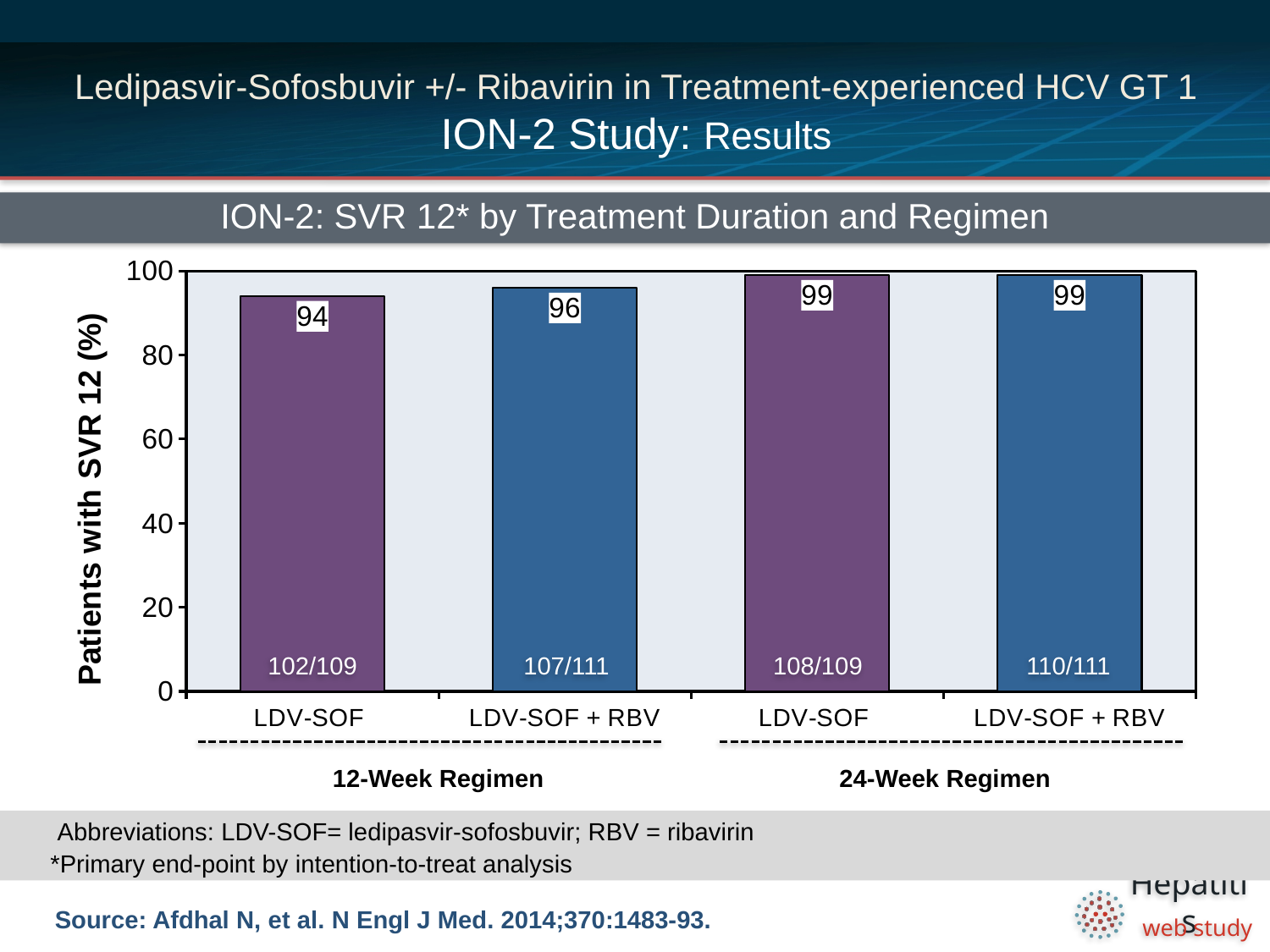
Which bar has the lowest SVR 12 rate? LDV-SOF, 12-Week Regimen What is the SVR 12 rate for LDV-SOF in the 12-Week Regimen? 94 What is the label of the y-axis? Patients with SVR 12 (%) What is the SVR 12 rate for LDV-SOF in the 24-Week Regimen? 99 What type of chart is shown on the slide? Bar chart What is the SVR 12 rate for LDV-SOF + RBV in the 12-Week Regimen? 96 Is the SVR 12 rate for LDV-SOF in the 12-Week Regimen greater or less than 80? greater What fraction of patients is shown inside the LDV-SOF + RBV bar in the 24-Week Regimen? 110/111 How many bars are shown in the chart? 4 What fraction of patients is shown inside the LDV-SOF bar in the 12-Week Regimen? 102/109 What is the difference in SVR 12 rate between LDV-SOF in the 24-Week Regimen and LDV-SOF in the 12-Week Regimen? 5 Which has a higher SVR 12 rate in the 12-Week Regimen, LDV-SOF or LDV-SOF + RBV? LDV-SOF + RBV